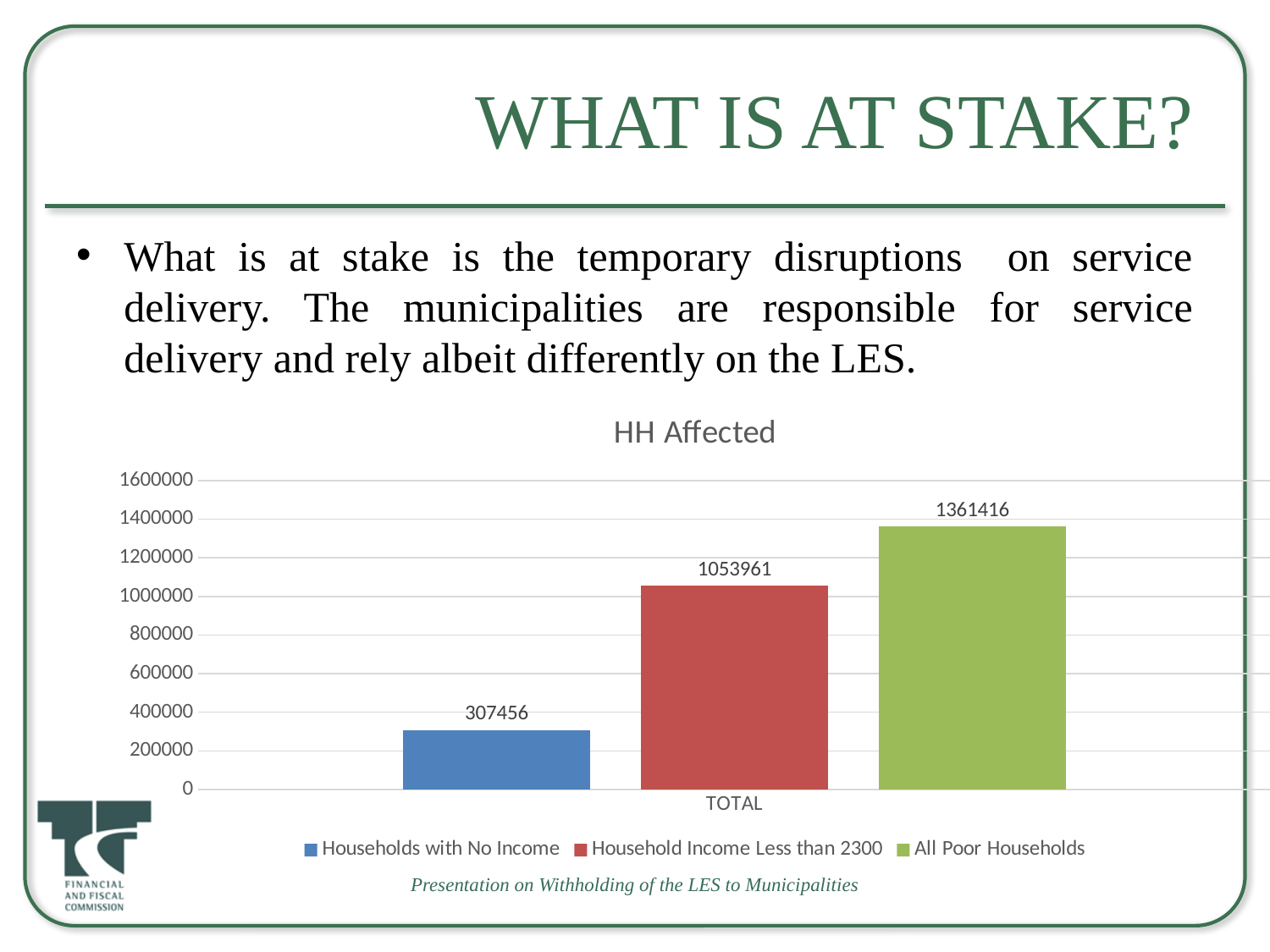
Which is larger in the HH Affected chart: Households with No Income or Household Income Less than 2300? Household Income Less than 2300 What is the difference between All Poor Households and Household Income Less than 2300 in the HH Affected chart? 307455 Which series has the highest value in the HH Affected chart? All Poor Households What kind of chart is the HH Affected chart? Bar chart Which series has the lowest value in the HH Affected chart? Households with No Income What is the category label shown on the x axis of the HH Affected chart? TOTAL What is the difference between Household Income Less than 2300 and Households with No Income in the HH Affected chart? 746505 What is the value for Households with No Income in the HH Affected chart? 307456 How many series does the legend of the HH Affected chart list? 3 Is the value for All Poor Households greater or less than 1200000? greater What is the value for All Poor Households in the HH Affected chart? 1361416 What is the value for Household Income Less than 2300 in the HH Affected chart? 1053961